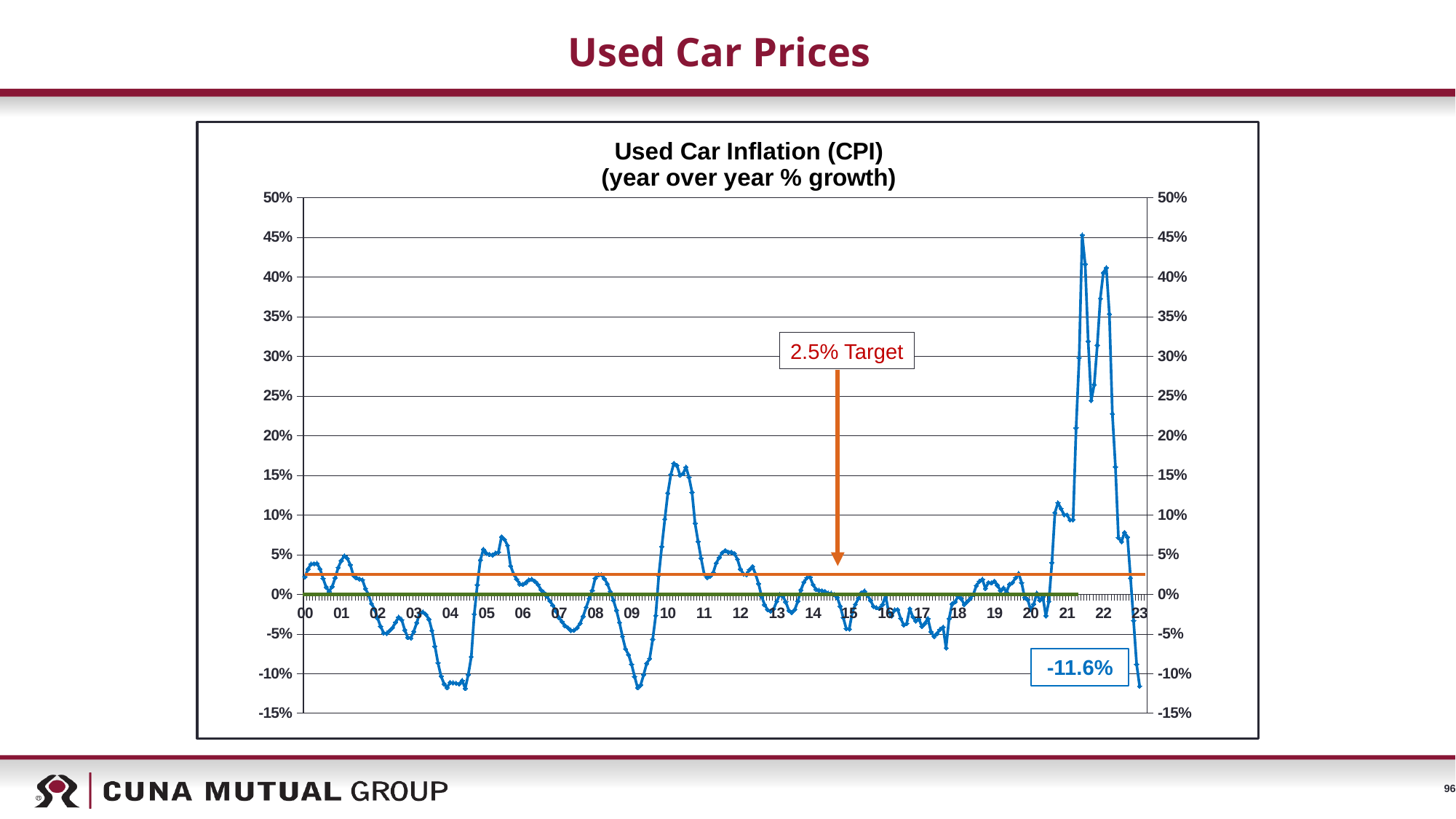
What kind of chart is shown on the slide? line chart What is the maximum value shown on the vertical axis? 50% Which year shows the highest used car inflation on the chart? 2021 Which peak is higher: the one around 2010 or the one in 2021? 2021 What is the title of the chart? Used Car Inflation (CPI) (year over year % growth) Is the peak value of used car inflation around 2010 greater or less than 10%? greater Is the lowest value of used car inflation around 2004 greater or less than -10%? less Is the peak value of used car inflation in 2021 greater or less than 40%? greater Does used car inflation rise or fall from its 2021 peak to 2023? fall How many year labels are shown on the horizontal axis? 24 What target value is marked by the horizontal orange line on the chart? 2.5% What is the most recent value of used car inflation labelled on the chart? -11.6%